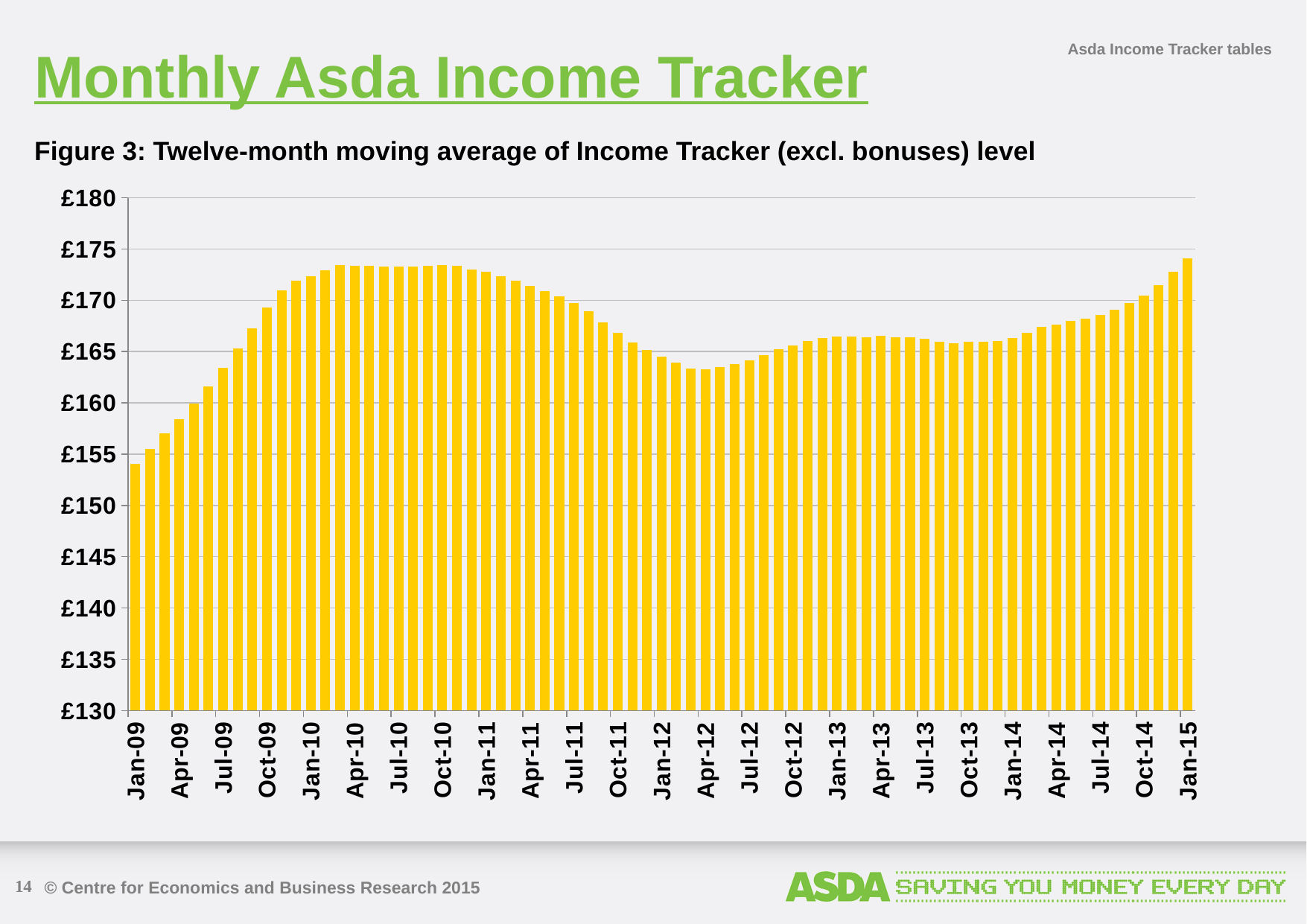
Around which labelled month does the chart reach its lowest value? Jan-09 Is the value for Jan-10 greater or less than £170? greater Is the value for Jan-15 greater or less than £170? greater Which is larger, the value for Apr-10 or the value for Apr-14? Apr-10 Do the values rise or fall from Jan-09 to Jan-10? Rise Is the value for Jan-14 greater or less than £170? less Do the values rise or fall from Jan-11 to Apr-12? Fall Which is larger, the value for Jan-09 or the value for Jan-15? Jan-15 What kind of chart is shown on the slide? Bar chart What is the title of the figure on the slide? Figure 3: Twelve-month moving average of Income Tracker (excl. bonuses) level